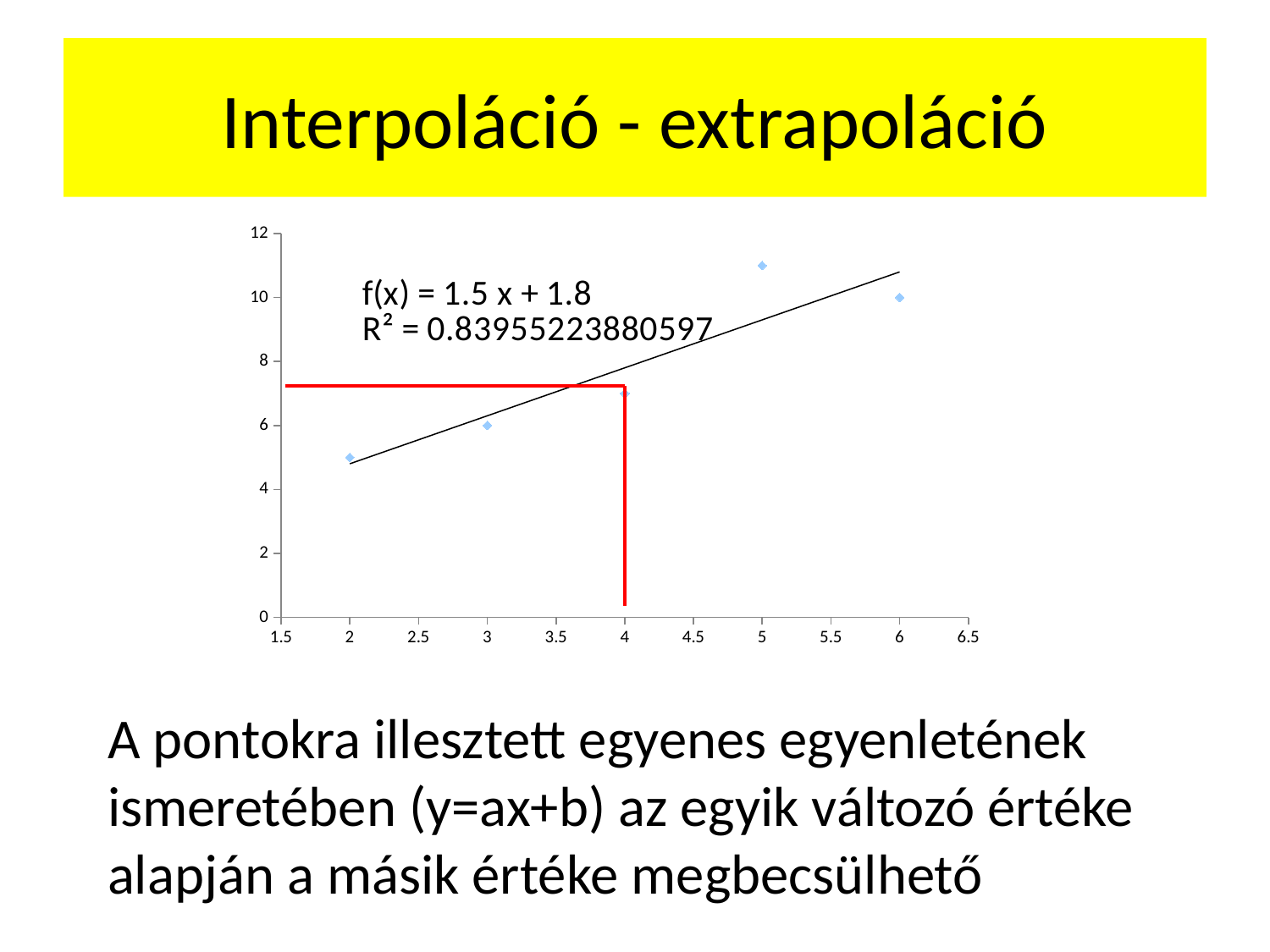
At which x value is the highest data point located? 5 How many data points are plotted on the chart? 5 What kind of chart is shown on the slide? scatter chart At which x value is the lowest data point located? 2 What is the equation of the fitted line shown on the chart? f(x) = 1.5 x + 1.8 Do the plotted values generally rise or fall as x increases? rise Is the y value of the data point at x = 4 greater or less than 8? less What is the y value of the data point at x = 6? 10 Is the y value of the data point at x = 2 greater or less than 4? greater Which data point has a larger y value, the one at x = 3 or the one at x = 6? x = 6 Is the y value of the data point at x = 5 greater or less than 10? greater What is the y value of the data point at x = 3? 6